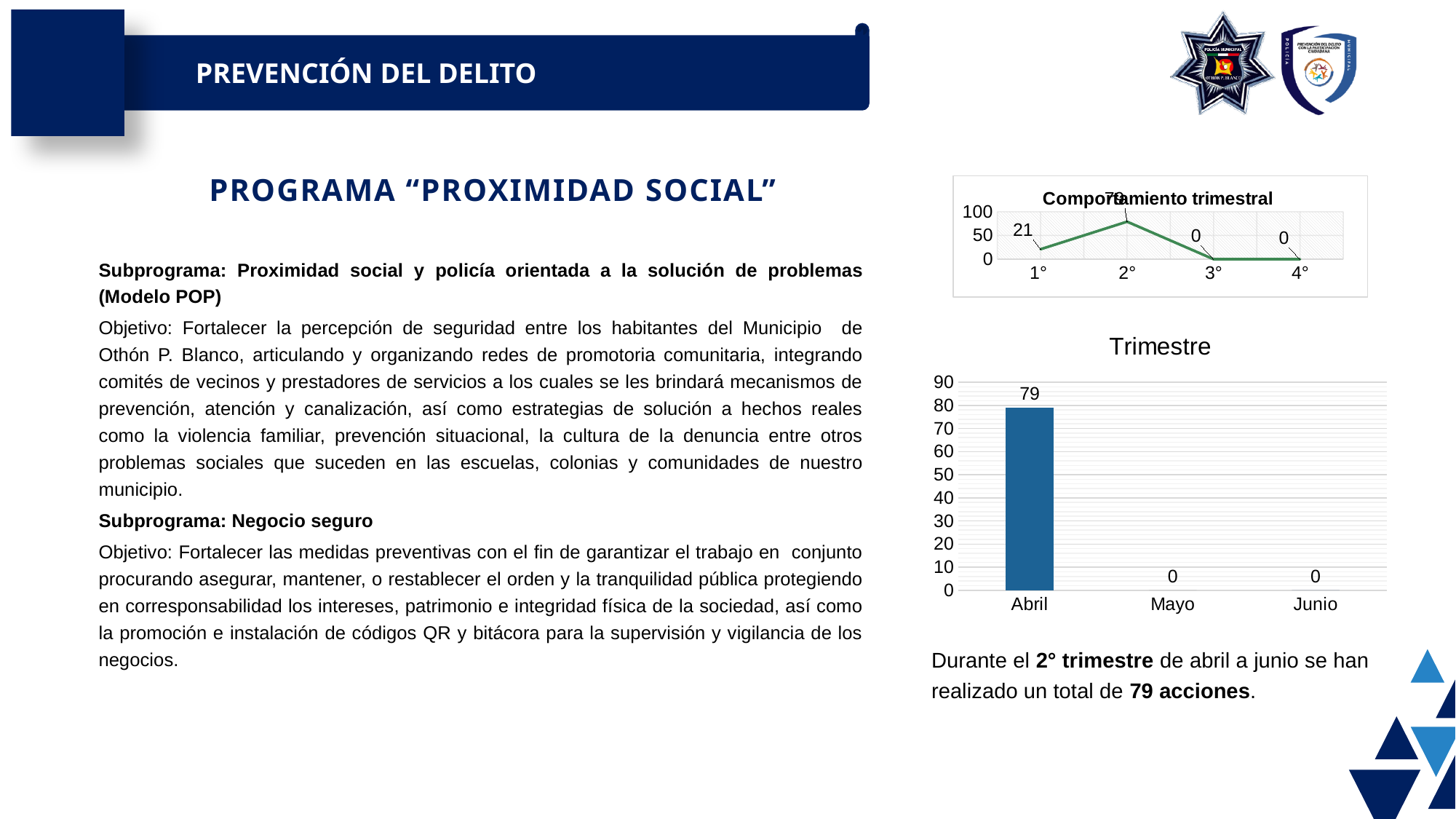
In the "Trimestre" chart, how many categories are shown on the x axis? 3 In the "Trimestre" chart, is the value for Abril greater or less than 70? greater In the "Trimestre" chart, what is the value for Mayo? 0 In the "Comportamiento trimestral" chart, which quarter has the highest value? 2° In the "Trimestre" chart, what is the value for Abril? 79 What kind of chart is the "Trimestre" chart? Bar chart In the "Trimestre" chart, which month has the highest value? Abril In the "Comportamiento trimestral" chart, what is the difference between the values for 2° and 1°? 58 What kind of chart is the "Comportamiento trimestral" chart? Line chart In the "Comportamiento trimestral" chart, how many data points are plotted? 4 In the "Comportamiento trimestral" chart, what is the value for 1°? 21 In the "Comportamiento trimestral" chart, what is the value for 2°? 79